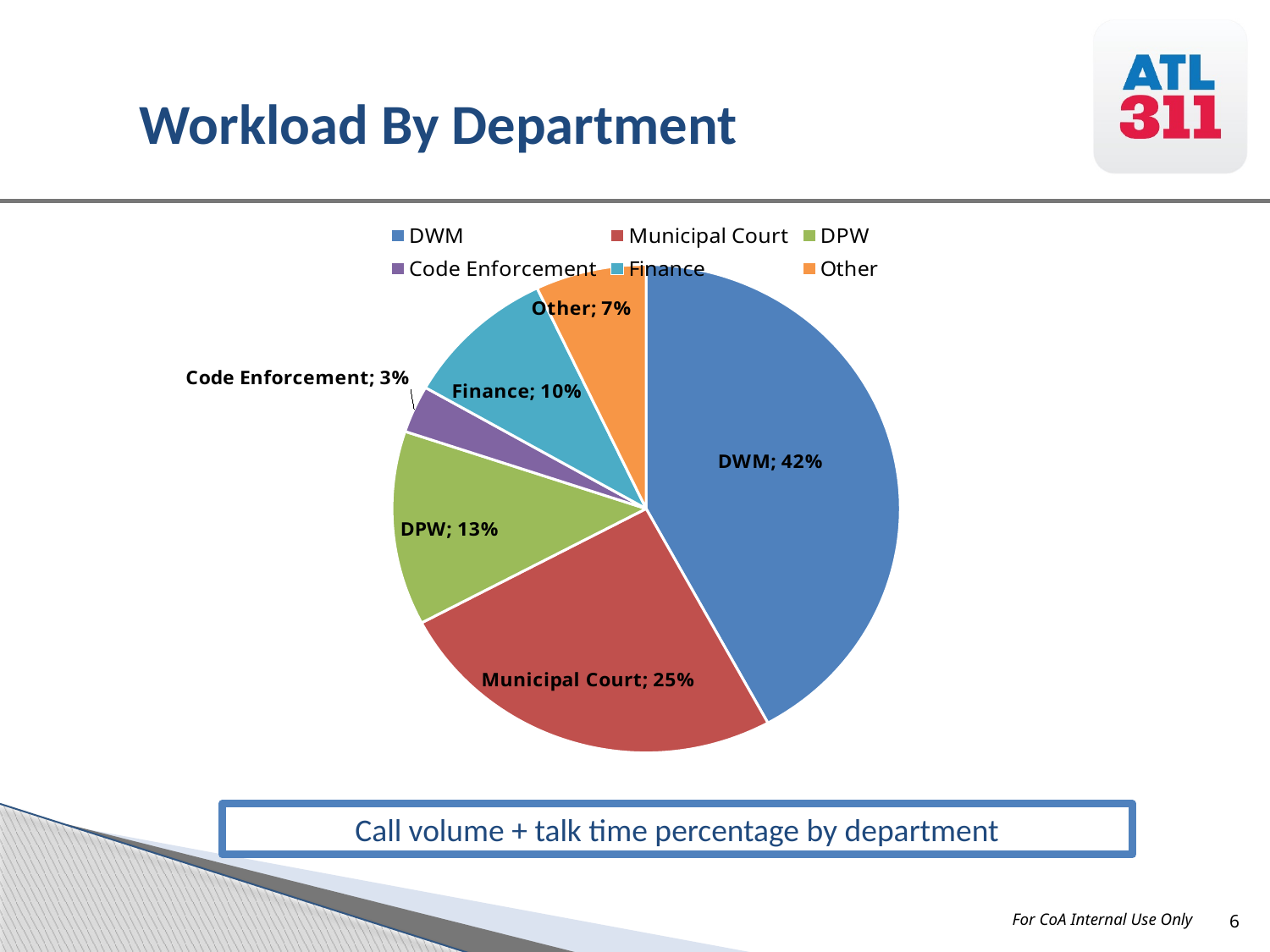
What is the difference in percentage points between DWM and Municipal Court? 17 What percentage of the workload is attributed to Code Enforcement? 3% What colour is the slice representing Other? Orange What is the title of the chart on the slide? Workload By Department What percentage of the workload is attributed to DWM? 42% Which has a larger share of the workload, DPW or Finance? DPW Which department has the smallest share of the workload? Code Enforcement What percentage of the workload is attributed to Finance? 10% Which department has the largest share of the workload? DWM How many departments (slices) are shown in the pie chart? 6 What percentage of the workload is attributed to Municipal Court? 25% What type of chart is shown on the slide? Pie chart